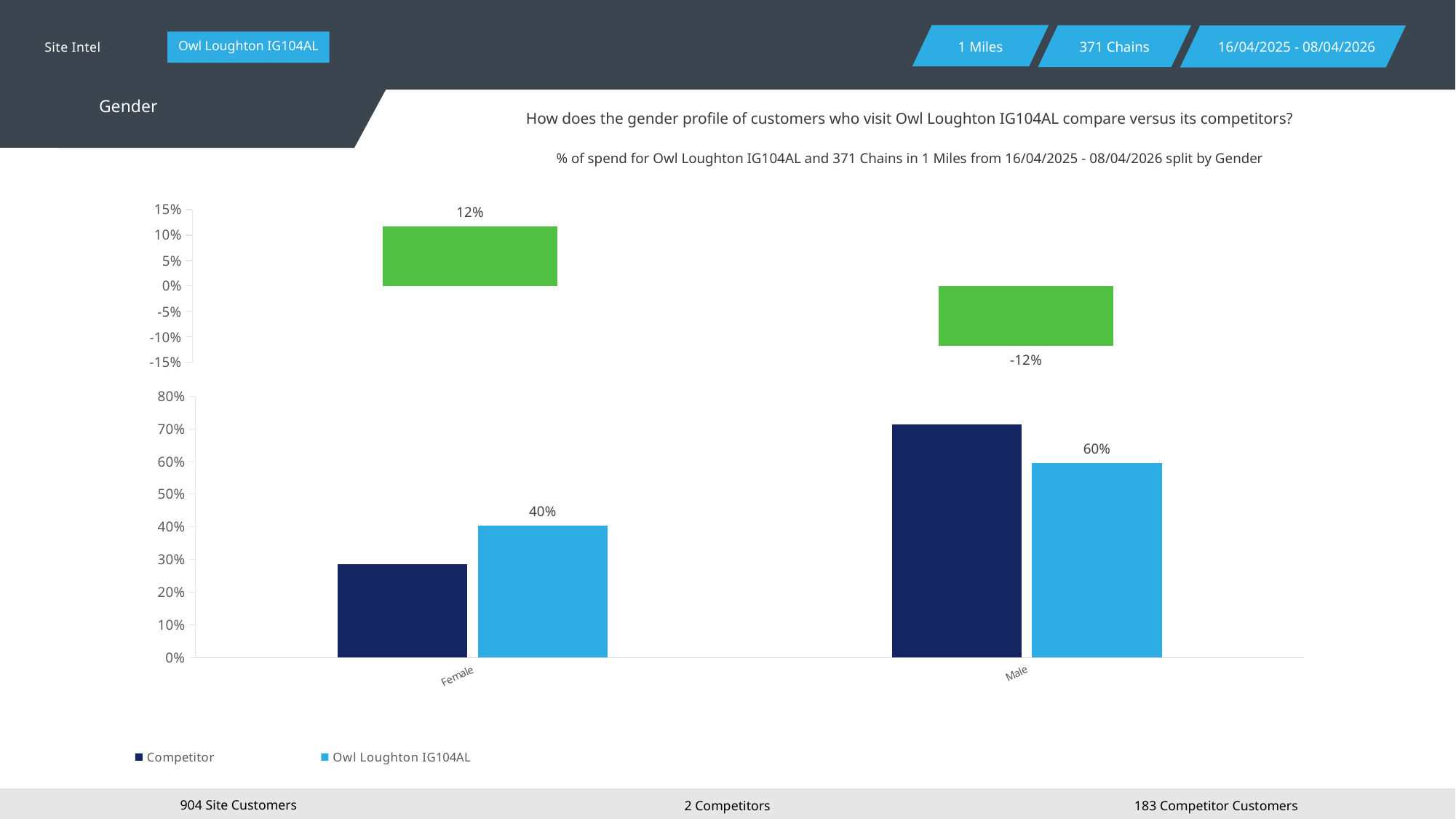
In the bottom bar chart, for the Male category, which is larger: the Competitor bar or the Owl Loughton IG104AL bar? Competitor In the bottom bar chart, is the Competitor value for Female greater or less than 30%? less In the bottom bar chart, what is the value for Owl Loughton IG104AL in the Male category? 60% In the top chart, what is the value shown for the Female category? 12% In the top chart, what is the value shown for the Male category? -12% In the bottom bar chart, is the Competitor value for Male greater or less than 70%? greater In the bottom bar chart, what is the value for Owl Loughton IG104AL in the Female category? 40% How many series does the legend of the bottom bar chart list? 2 In the bottom bar chart, which category has the higher value for Owl Loughton IG104AL? Male In the bottom bar chart, for the Female category, which is larger: the Competitor bar or the Owl Loughton IG104AL bar? Owl Loughton IG104AL What type of chart is the bottom chart on the slide? Bar chart In the bottom bar chart, what is the difference between the Owl Loughton IG104AL values for Male and Female? 20%